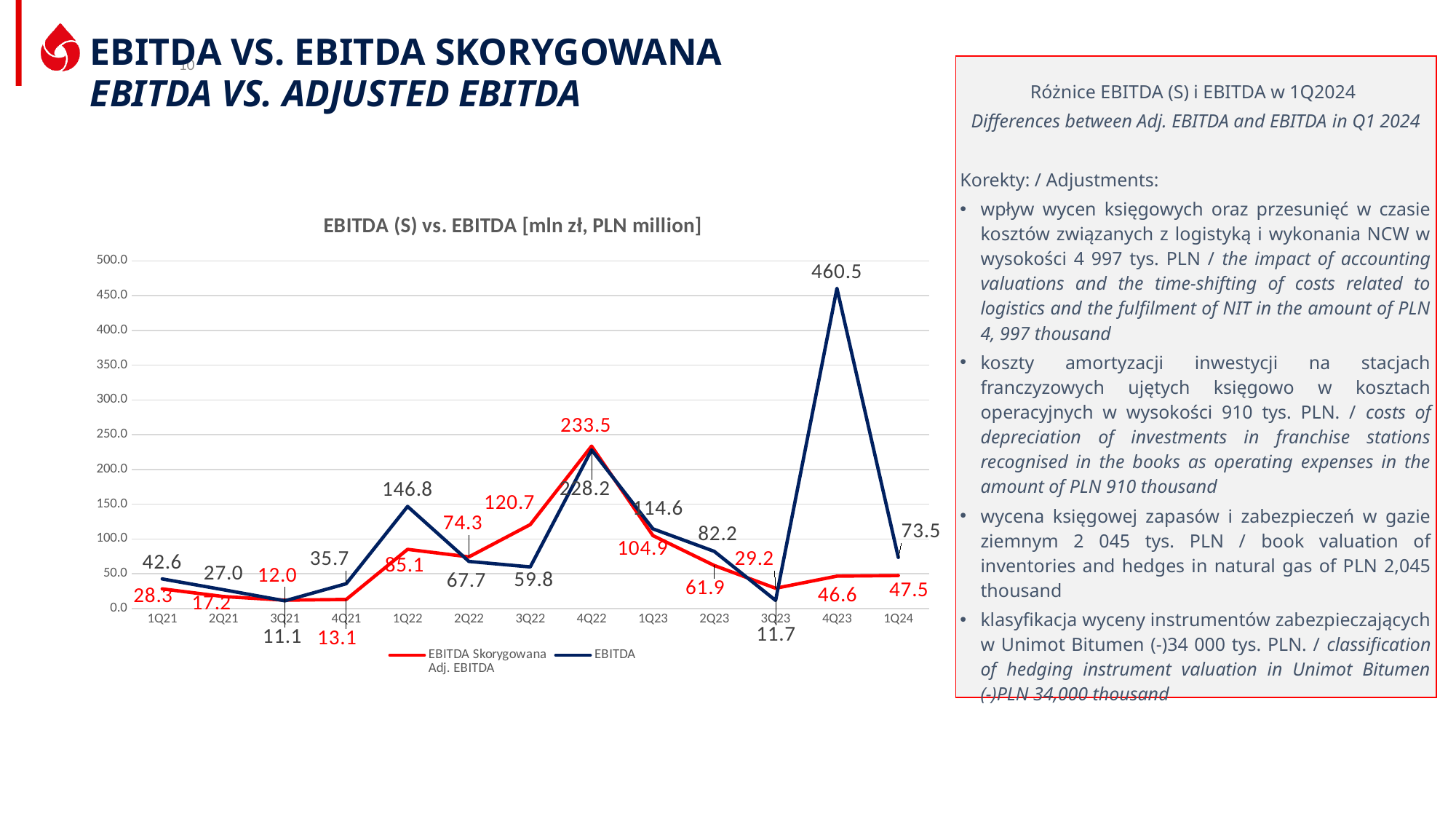
In which quarter does the EBITDA series reach its highest value? 4Q23 In 1Q22, which is larger: EBITDA or Adj. EBITDA? EBITDA What is the Adj. EBITDA (EBITDA Skorygowana) value for 4Q22? 233.5 What is the difference between Adj. EBITDA and EBITDA in 4Q22? 5.3 In which quarter is the Adj. EBITDA (EBITDA Skorygowana) series at its lowest? 3Q21 What is the difference between EBITDA and Adj. EBITDA in 1Q24? 26.0 How many series does the legend of the chart list? 2 What type of chart is shown on the slide? line chart What is the title of the chart? EBITDA (S) vs. EBITDA [mln zł, PLN million] How many quarters are plotted along the x axis of the chart? 13 What is the EBITDA value for 4Q23? 460.5 What is the Adj. EBITDA (EBITDA Skorygowana) value for 1Q24? 47.5